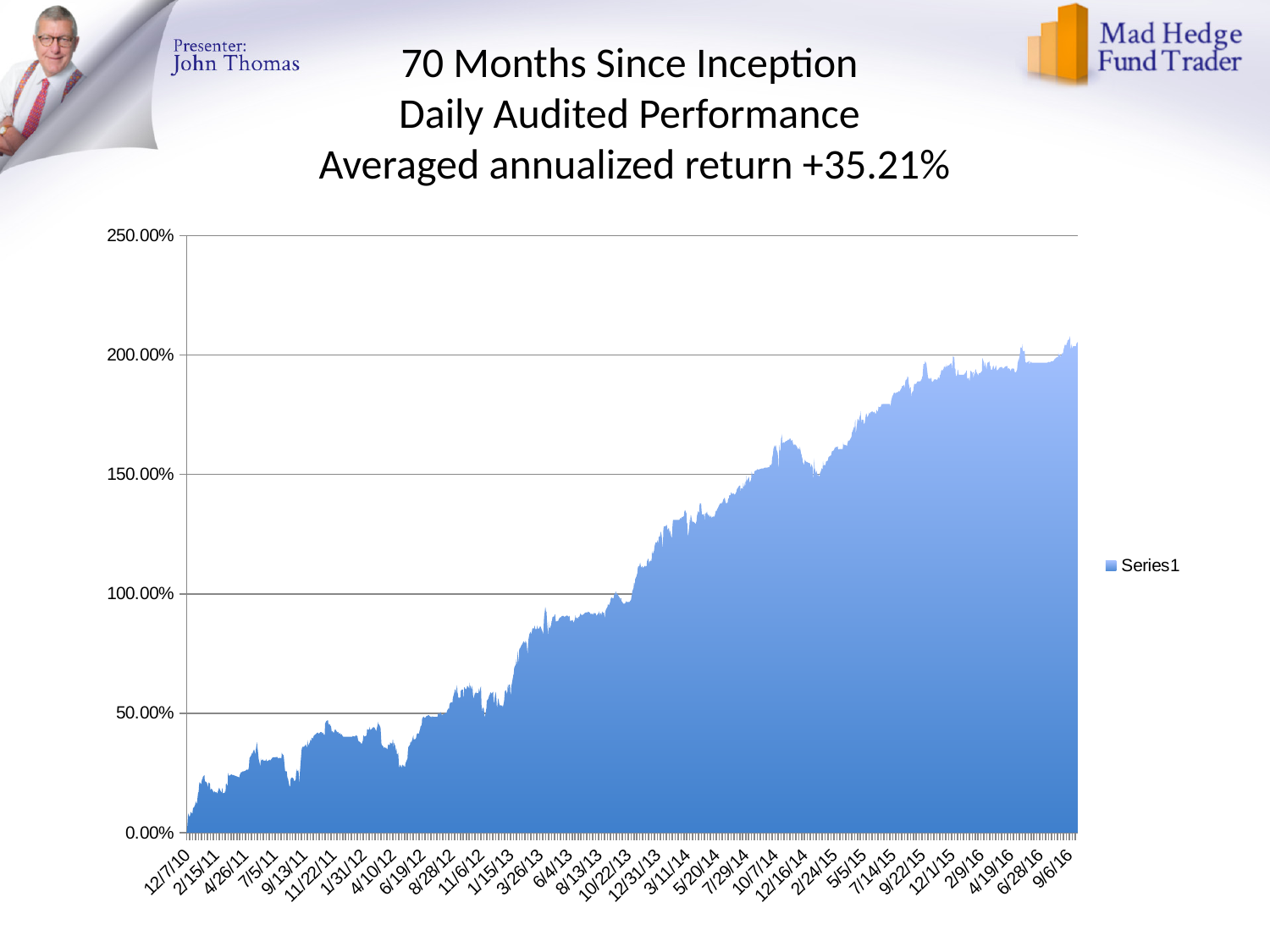
What is the highest value shown on the y axis? 250.00% How many series does the legend list? 1 Is the value at 10/7/14 greater or less than 100%? greater Is the value at 3/11/14 greater or less than 100%? greater Is the value at 6/4/13 greater or less than 50%? greater What kind of chart is shown on the slide? area chart Do the values generally rise or fall from 12/7/10 to 9/6/16? rise Which is larger, the value at 9/6/16 or the value at 12/7/10? 9/6/16 What is the name of the series shown in the legend? Series1